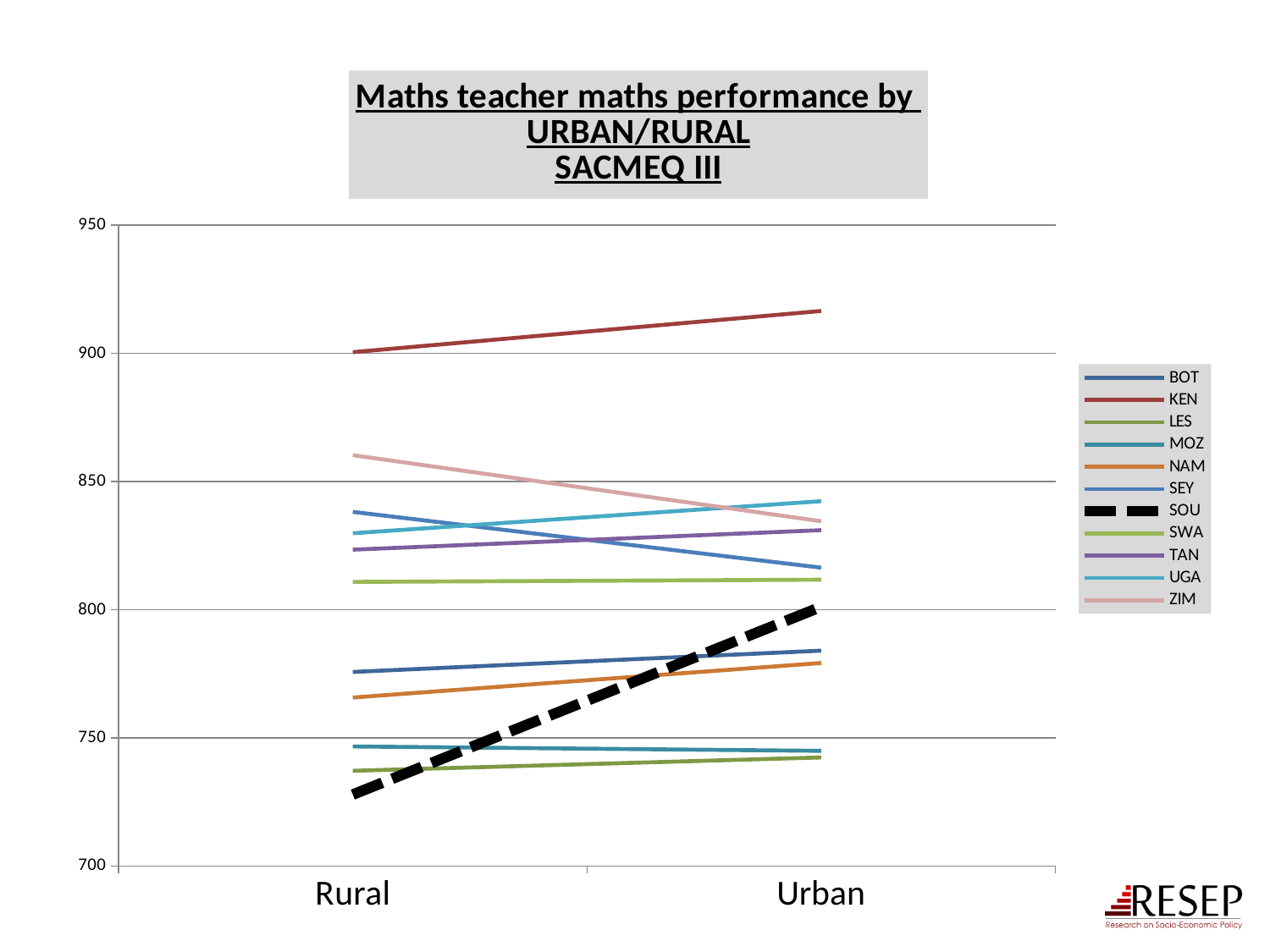
Which country has the highest maths teacher performance for Urban? KEN Is the Urban value for KEN greater or less than 900? greater Which series is drawn with a thick black dashed line? SOU How many series does the legend list? 11 Does the value for SOU rise or fall from Rural to Urban? rise How many categories are shown on the x axis? 2 Which country has the highest maths teacher performance for Rural? KEN Which country has the lowest maths teacher performance for Rural? SOU Is the Rural value for SOU greater or less than 750? less Is the Rural value for ZIM greater or less than 850? greater What kind of chart is shown on the slide? line chart Does the value for ZIM rise or fall from Rural to Urban? fall